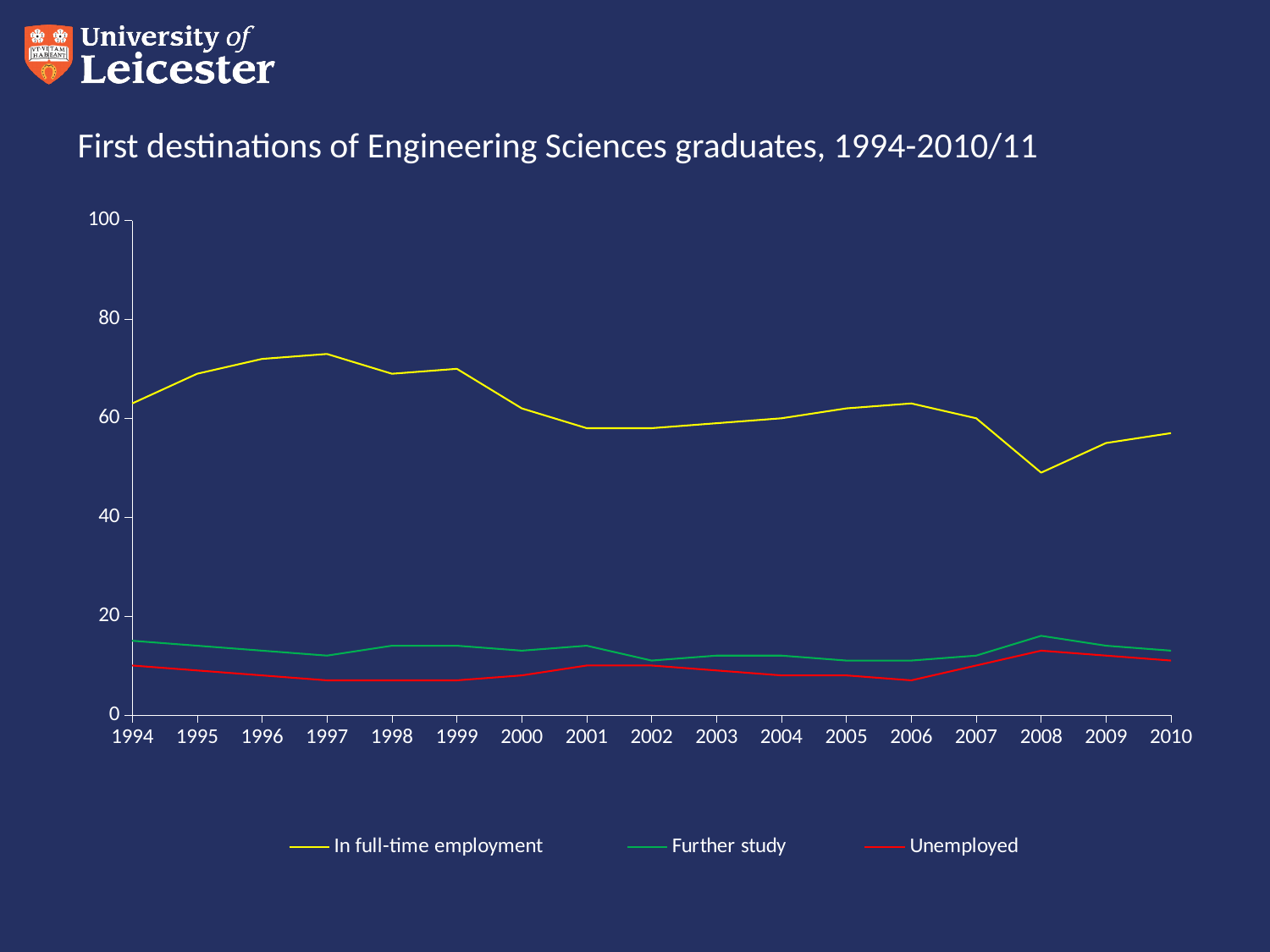
Is the value for In full-time employment in 2008 greater or less than 60? less Does the value for In full-time employment rise or fall from 2007 to 2008? Fall How many years are shown along the x axis? 17 Which series is drawn in red? Unemployed What kind of chart is shown on the slide? Line chart In which year is the value for In full-time employment lowest? 2008 In 1994, which is larger: Further study or Unemployed? Further study Is the value for In full-time employment in 1997 greater or less than 80? less Is the value for In full-time employment in 1994 greater or less than 60? greater How many series does the legend list? 3 What is the title of the chart? First destinations of Engineering Sciences graduates, 1994-2010/11